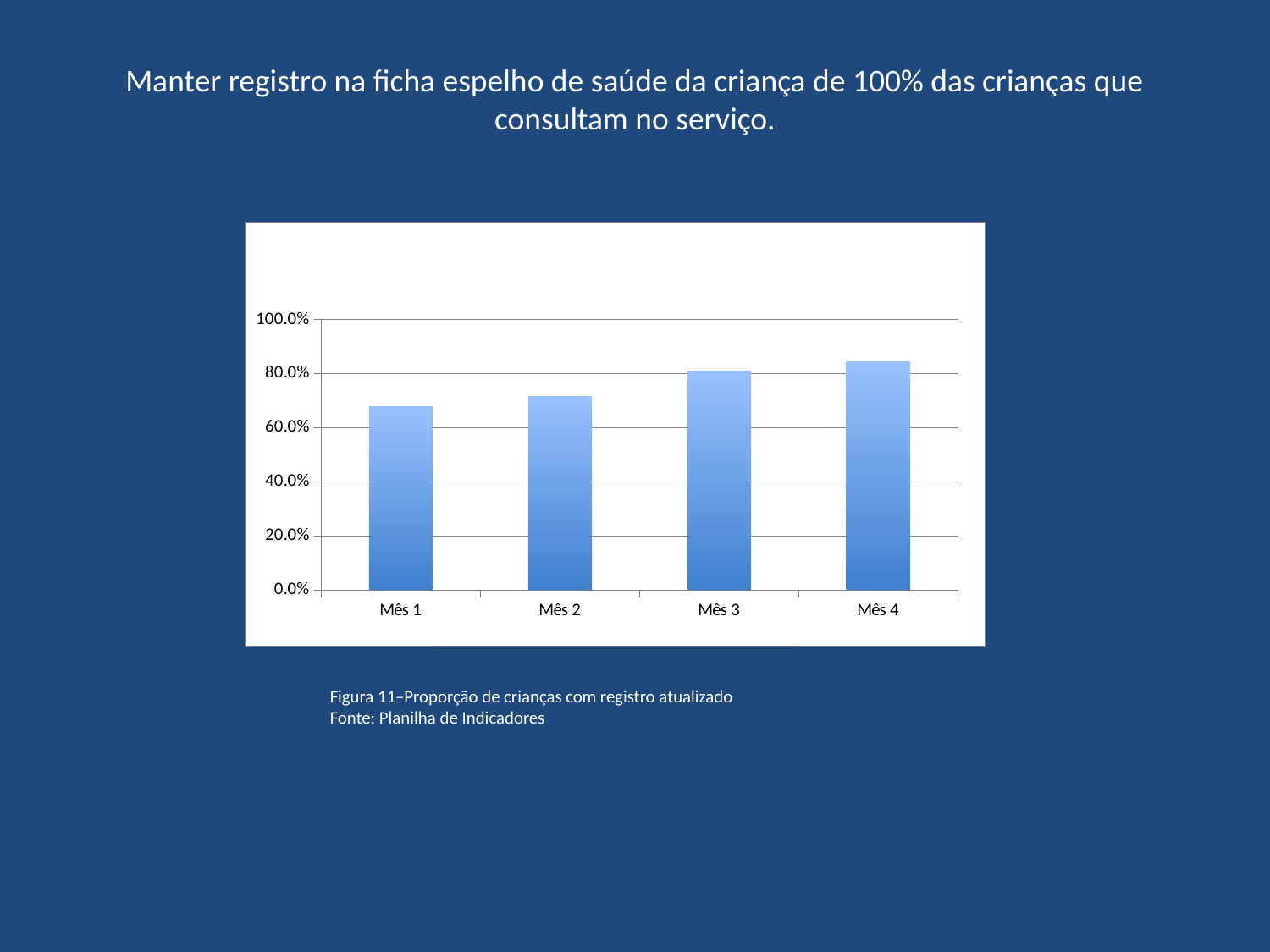
Which month has the lowest bar? Mês 1 What kind of chart is shown on the slide? bar chart Which is larger, the value for Mês 1 or the value for Mês 2? Mês 2 Is the value for Mês 4 greater or less than 80.0%? greater According to the caption, what is the source of the data in the chart? Planilha de Indicadores Is the value for Mês 3 greater or less than 60.0%? greater Is the value for Mês 1 greater or less than 60.0%? greater Do the values rise or fall from Mês 1 to Mês 4? rise Which month has the highest bar? Mês 4 What is the highest value shown on the y axis? 100.0% How many categories (months) are plotted on the x axis? 4